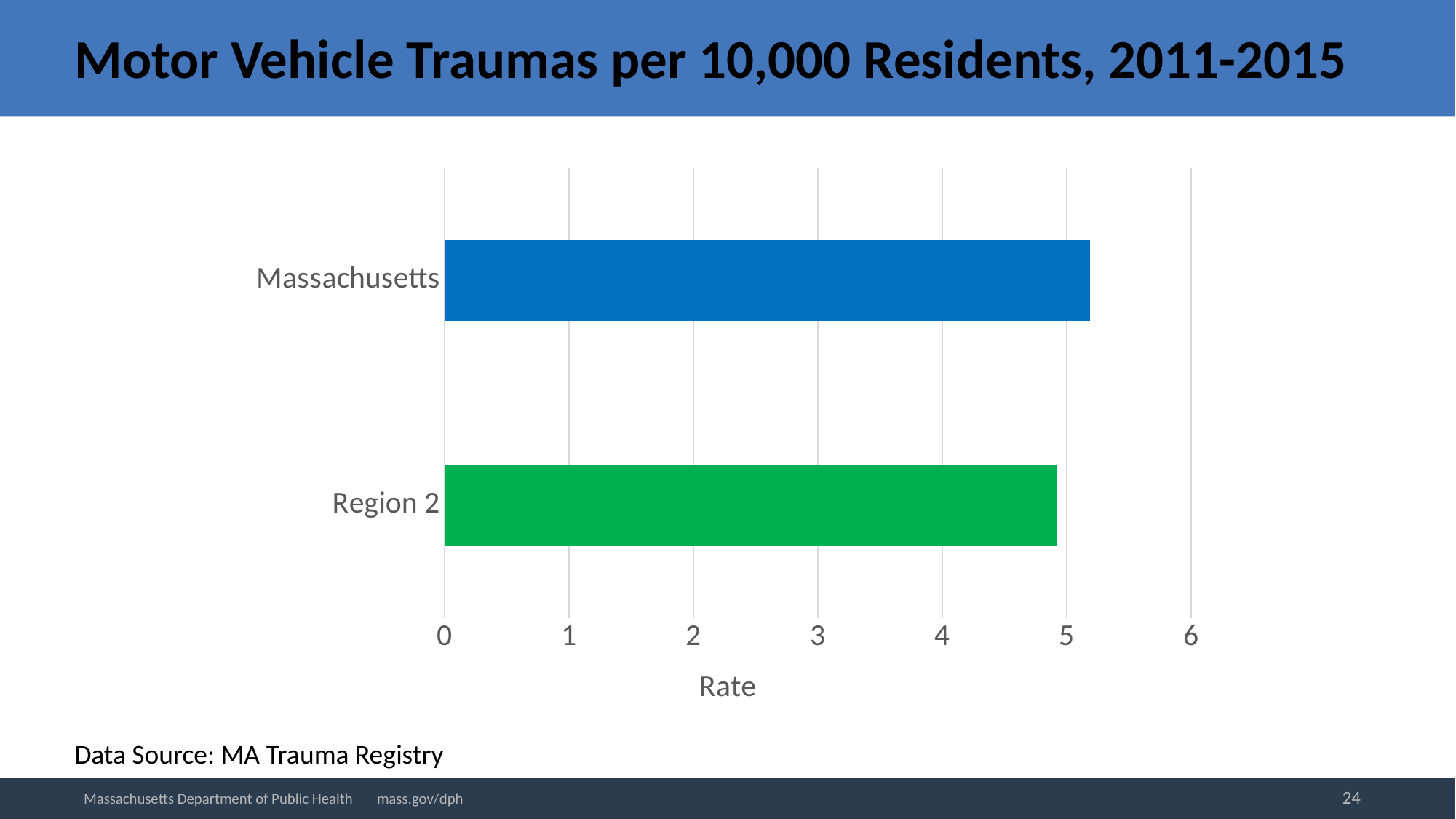
Is the value for Region 2 greater or less than 4? greater What is the label on the horizontal axis of the chart? Rate What kind of chart is shown on the slide? bar chart What is the title of the slide containing the chart? Motor Vehicle Traumas per 10,000 Residents, 2011-2015 Is the value for Massachusetts greater or less than 5? greater Is the value for Region 2 greater or less than 3? greater Which has the larger rate, Massachusetts or Region 2? Massachusetts Which category has the lowest motor vehicle trauma rate? Region 2 How many categories are plotted in the chart? 2 Which category has the highest motor vehicle trauma rate? Massachusetts